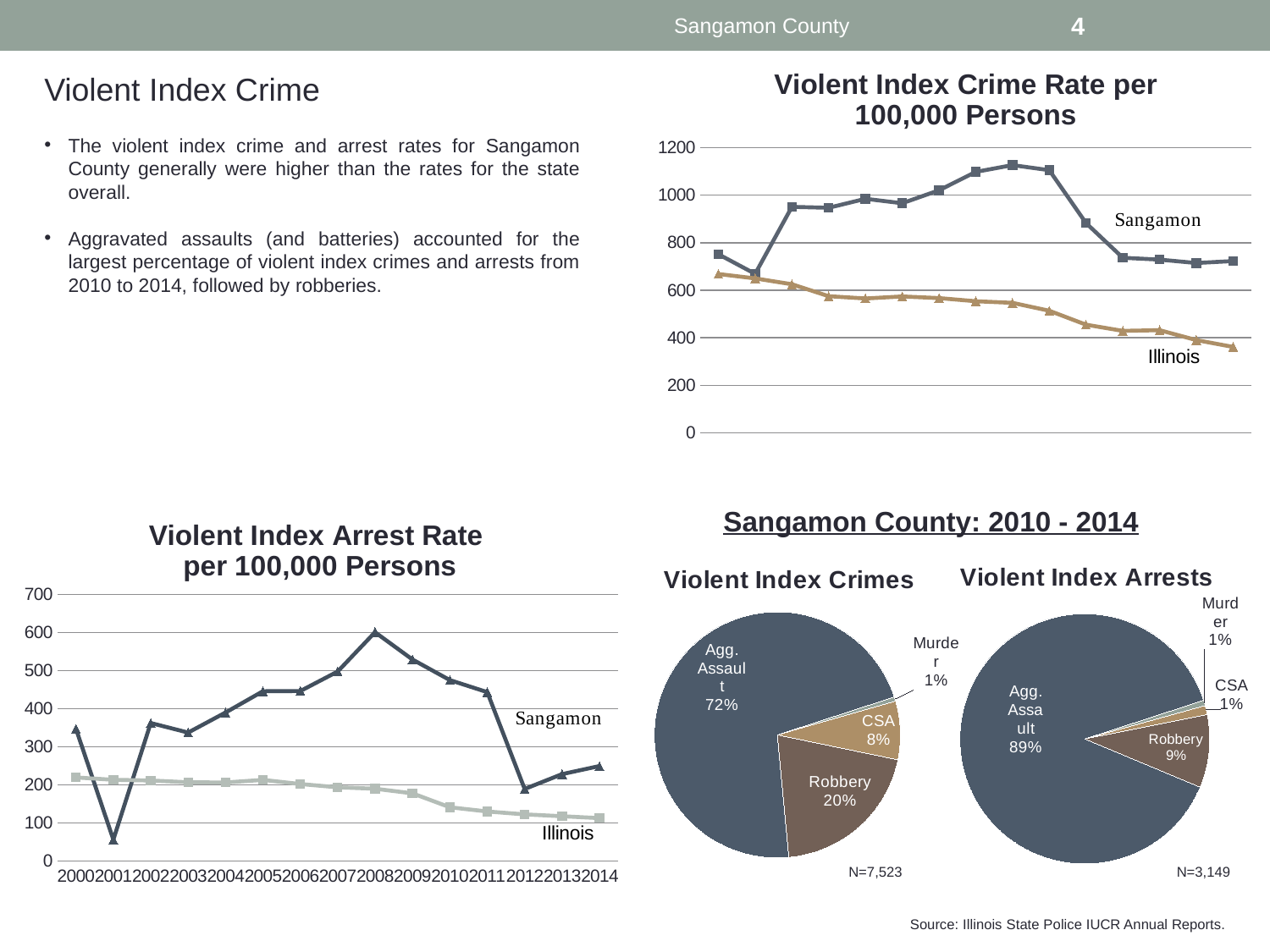
In the Violent Index Arrests pie chart, what percentage is Agg. Assault? 89% In the Violent Index Arrest Rate per 100,000 Persons chart, in which year does the Sangamon line reach its highest point? 2008 In the Violent Index Arrest Rate per 100,000 Persons chart, does the Illinois line generally rise or fall from 2000 to 2014? Fall In the Violent Index Arrest Rate per 100,000 Persons chart, is the Sangamon value for 2008 greater or less than 500? greater How many percentage points higher is the Agg. Assault share in the Violent Index Arrests pie than in the Violent Index Crimes pie? 17 percentage points What is the N value shown under the Violent Index Arrests pie chart? N=3,149 What type of chart is the Violent Index Crime Rate per 100,000 Persons chart? Line chart How many slices does the Violent Index Crimes pie chart have? 4 In the Violent Index Crime Rate per 100,000 Persons chart, is the final Illinois value greater or less than 400? less In the Violent Index Crimes pie chart, what share of crimes is Robbery? 20% In the Violent Index Arrests pie chart, which category has the largest slice? Agg. Assault How many series are plotted in the Violent Index Arrest Rate per 100,000 Persons chart? 2